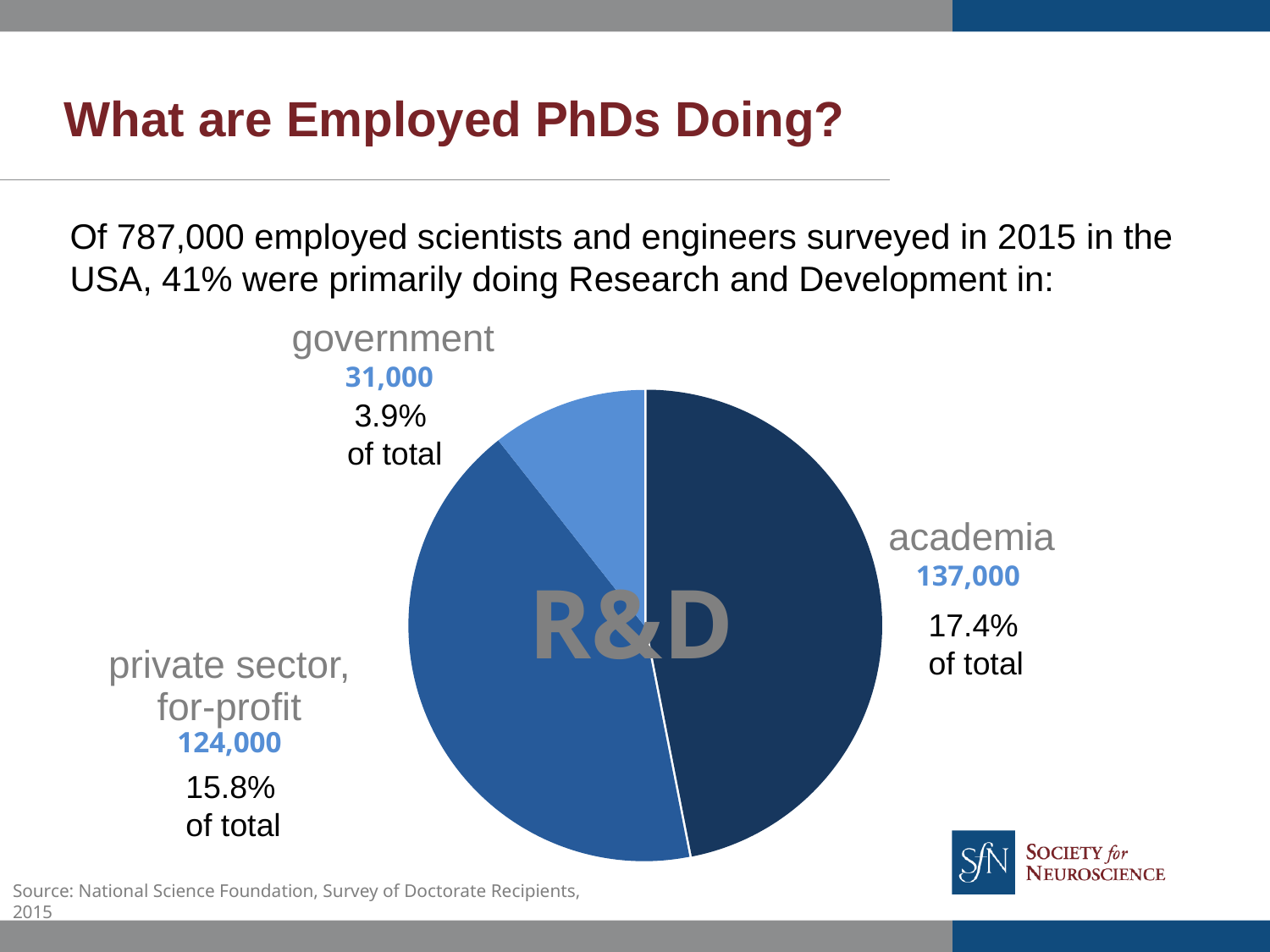
What text is written in the centre of the pie chart? R&D Which category has the largest slice? academia What percentage of the total does government represent? 3.9% What percentage of the total does academia represent? 17.4% What is the value for academia? 137,000 How many slices does the pie chart have? 3 What is the difference between the academia and private sector, for-profit values? 13,000 What is the value for government? 31,000 What kind of chart is shown on the slide? pie chart What is the value for private sector, for-profit? 124,000 Which category has the smallest slice? government Which is larger, the value for private sector, for-profit or the value for government? private sector, for-profit